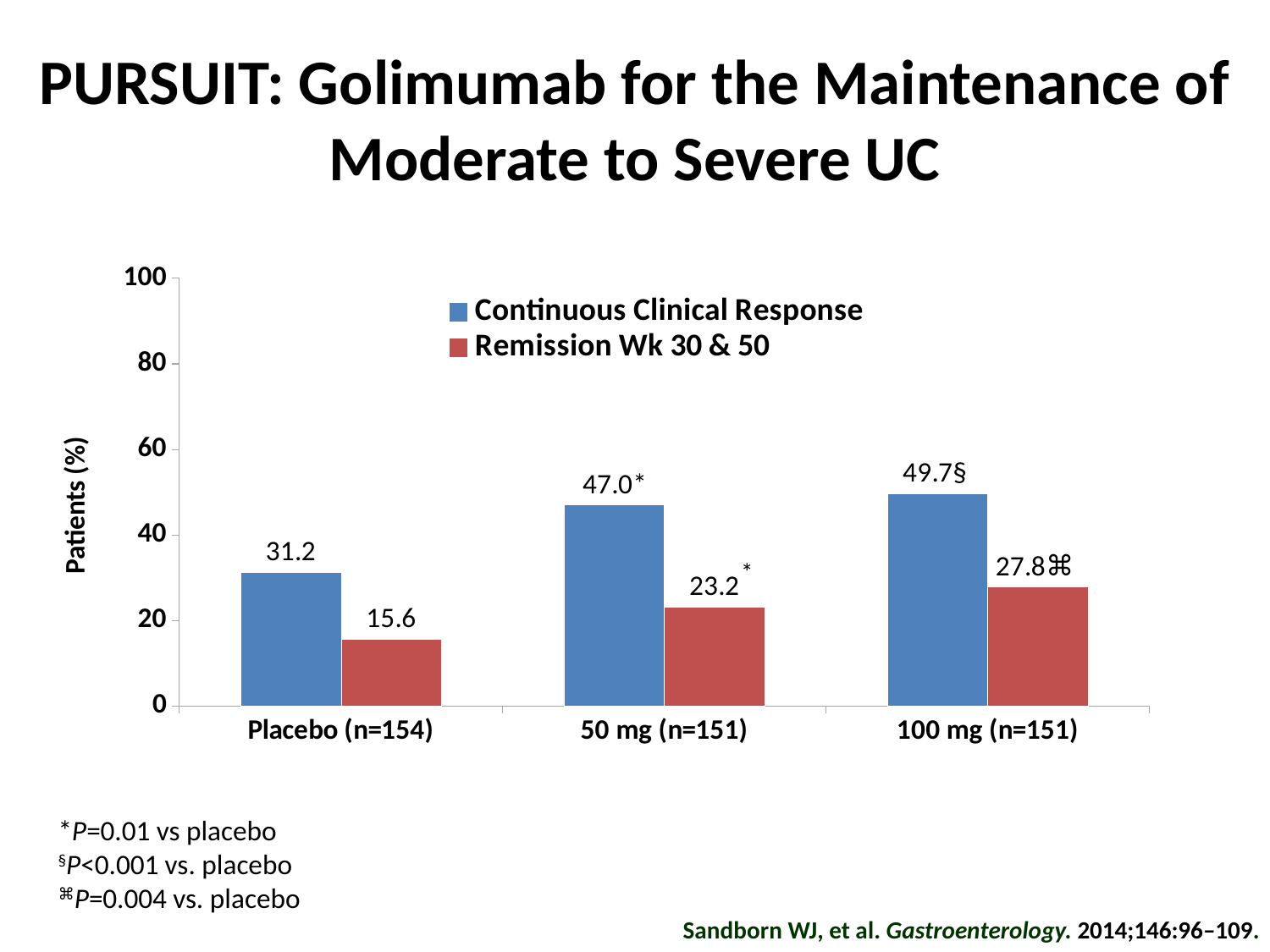
What is the Remission Wk 30 & 50 value for the 50 mg (n=151) group? 23.2 What is the Continuous Clinical Response value for the 100 mg (n=151) group? 49.7 What kind of chart is shown on the slide? Bar chart What is the difference between the Continuous Clinical Response values for the 50 mg (n=151) and Placebo (n=154) groups? 15.8 What is the label of the y axis? Patients (%) Which group has the highest Continuous Clinical Response value? 100 mg (n=151) What is the Continuous Clinical Response value for the Placebo (n=154) group? 31.2 How many treatment groups are shown on the x axis? 3 Which group has the lowest Remission Wk 30 & 50 value? Placebo (n=154) How many series does the legend list? 2 Which is larger: the Remission Wk 30 & 50 value for 100 mg (n=151) or for 50 mg (n=151)? 100 mg (n=151) Is the Continuous Clinical Response value for the 50 mg (n=151) group greater or less than 40? greater